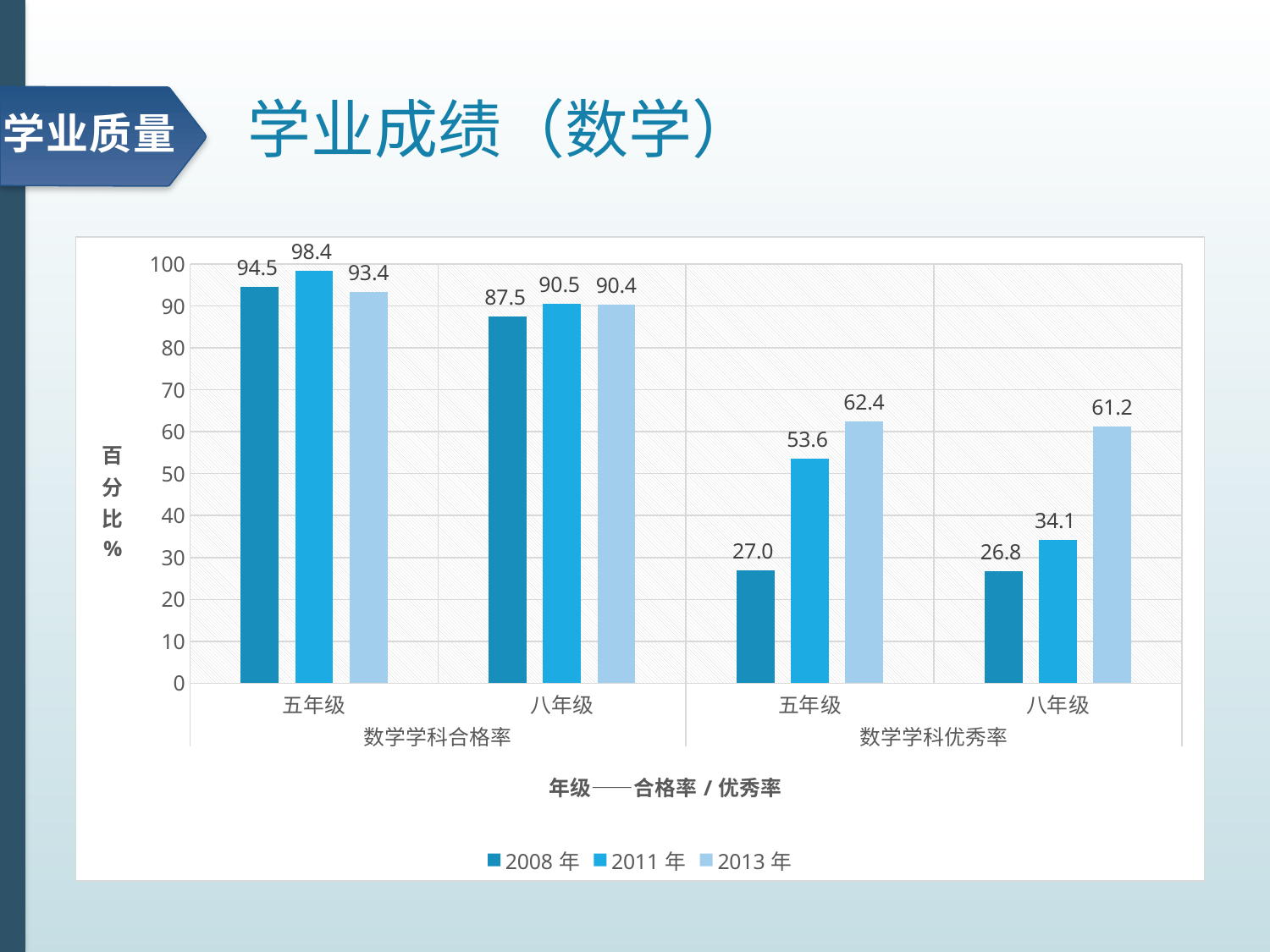
What is the difference between the 2013 年 and 2008 年 values for 八年级 under 数学学科优秀率? 34.4 What kind of chart is shown on the slide? bar chart How many category groups are shown on the x axis? 4 Is the 2008 年 value for 五年级 under 数学学科优秀率 greater or less than 30? less What is the label of the y axis? 百分比% Which year has the lowest value for 五年级 under 数学学科优秀率? 2008 年 What is the 2008 年 value for 八年级 under 数学学科优秀率? 26.8 Which year has the highest value for 八年级 under 数学学科合格率? 2011 年 What is the 2013 年 value for 五年级 under 数学学科优秀率? 62.4 Which is larger: the 2011 年 value for 五年级 under 数学学科优秀率, or the 2011 年 value for 八年级 under 数学学科优秀率? 五年级 How many series does the legend list? 3 What is the 2011 年 value for 五年级 under 数学学科合格率? 98.4